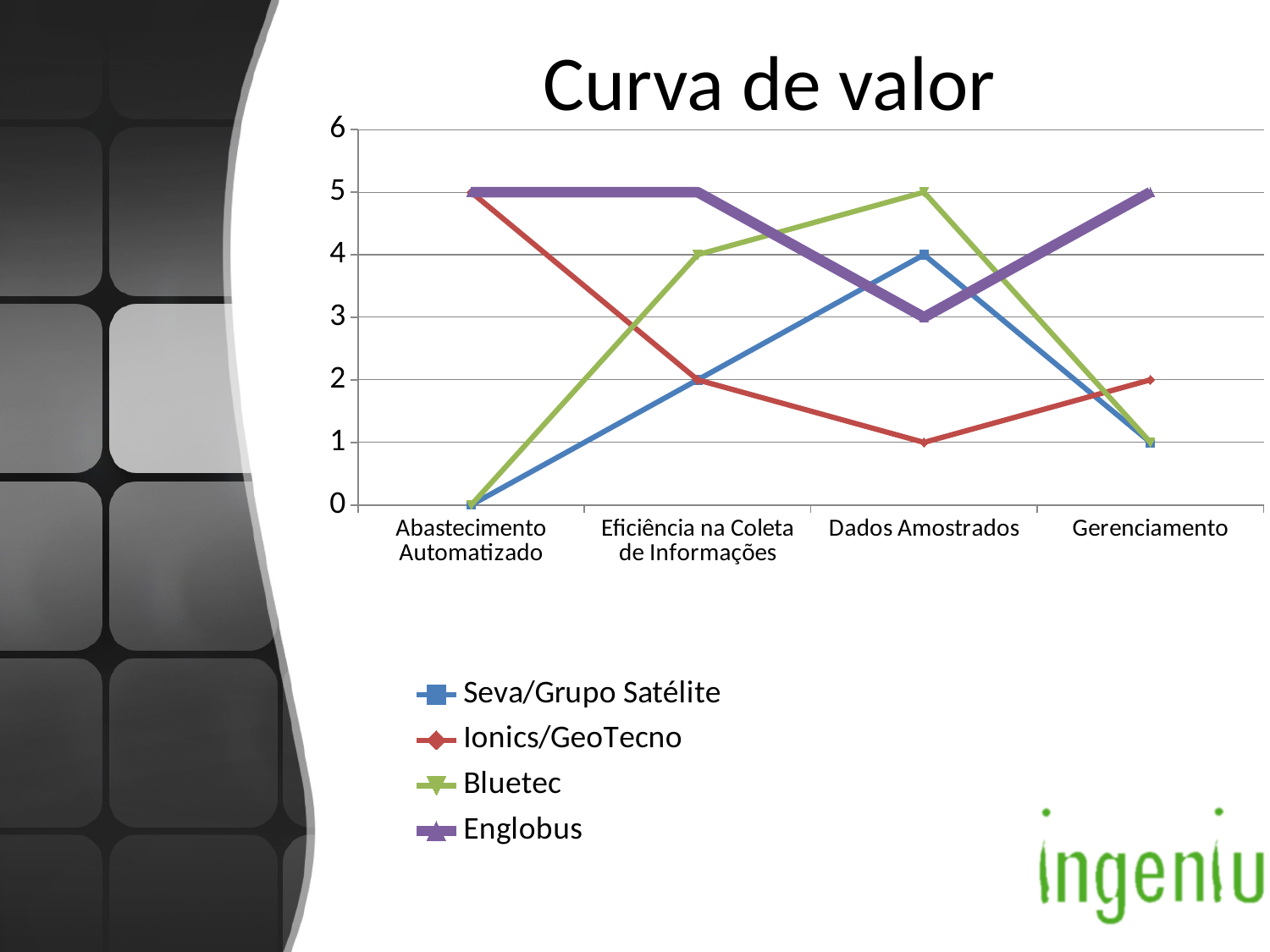
Which series has the highest value at Gerenciamento? Englobus What is the value for Seva/Grupo Satélite at Gerenciamento? 1 What is the value for Bluetec at Eficiência na Coleta de Informações? 4 What is the title of the chart? Curva de valor How many series does the legend list? 4 What is the value for Ionics/GeoTecno at Abastecimento Automatizado? 5 How many categories are shown on the x axis? 4 What type of chart is shown on the slide? Line chart What is the value for Englobus at Dados Amostrados? 3 What is the difference between Bluetec and Ionics/GeoTecno at Dados Amostrados? 4 Does the Ionics/GeoTecno line rise or fall from Abastecimento Automatizado to Dados Amostrados? Fall Which series has the lowest value at Dados Amostrados? Ionics/GeoTecno